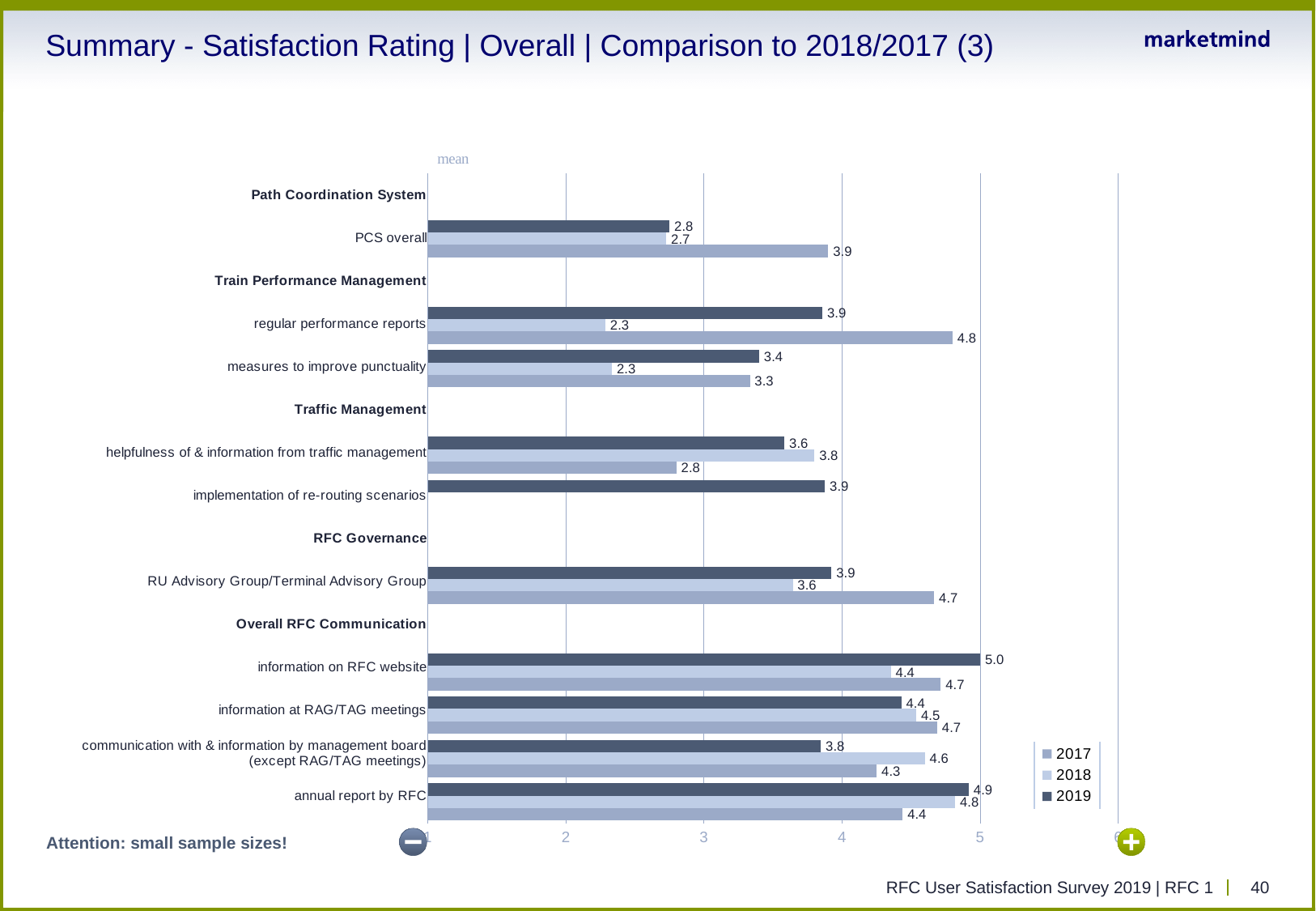
What kind of chart is shown on the slide? bar chart For PCS overall, which year has the higher mean rating, 2017 or 2019? 2017 What is the 2018 mean rating for communication with & information by management board (except RAG/TAG meetings)? 4.6 What is the 2019 mean rating for implementation of re-routing scenarios? 3.9 What is the 2019 mean satisfaction rating for information on RFC website? 5.0 What is the difference between the 2017 and 2018 mean ratings for regular performance reports? 2.5 How many series does the legend list? 3 For annual report by RFC, is the 2019 mean rating greater or less than 4? greater Which year is shown with the darkest bars in the legend? 2019 What is the 2017 mean rating for regular performance reports? 4.8 Which item has the lowest 2017 mean rating? helpfulness of & information from traffic management Which item has the highest 2019 mean rating? information on RFC website